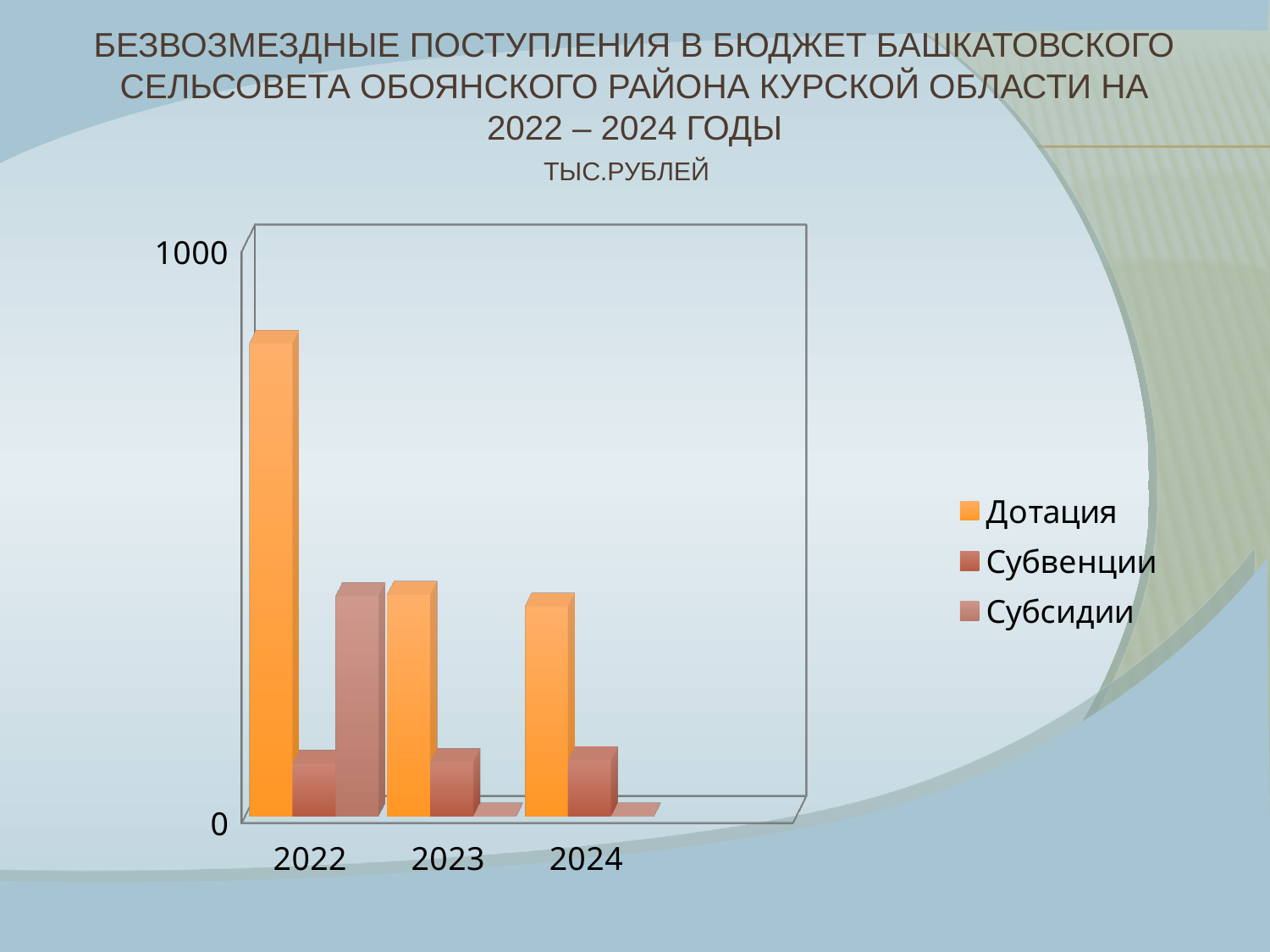
Which series has the highest value in 2022? Дотация Which is larger in 2022, Субсидии or Субвенции? Субсидии Is the value for Дотация in 2022 greater or less than 1000? less What unit of measurement is stated under the chart title? ТЫС.РУБЛЕЙ What kind of chart is shown on the slide? Bar chart In which year is the value for Дотация highest? 2022 How many years (categories) are shown on the x axis? 3 Which is larger in 2022, Дотация or Субвенции? Дотация Which series has the lowest value in 2023? Субсидии How many series does the legend list? 3 Do the values for Дотация rise or fall from 2022 to 2024? fall In which year is the value for Субсидии highest? 2022